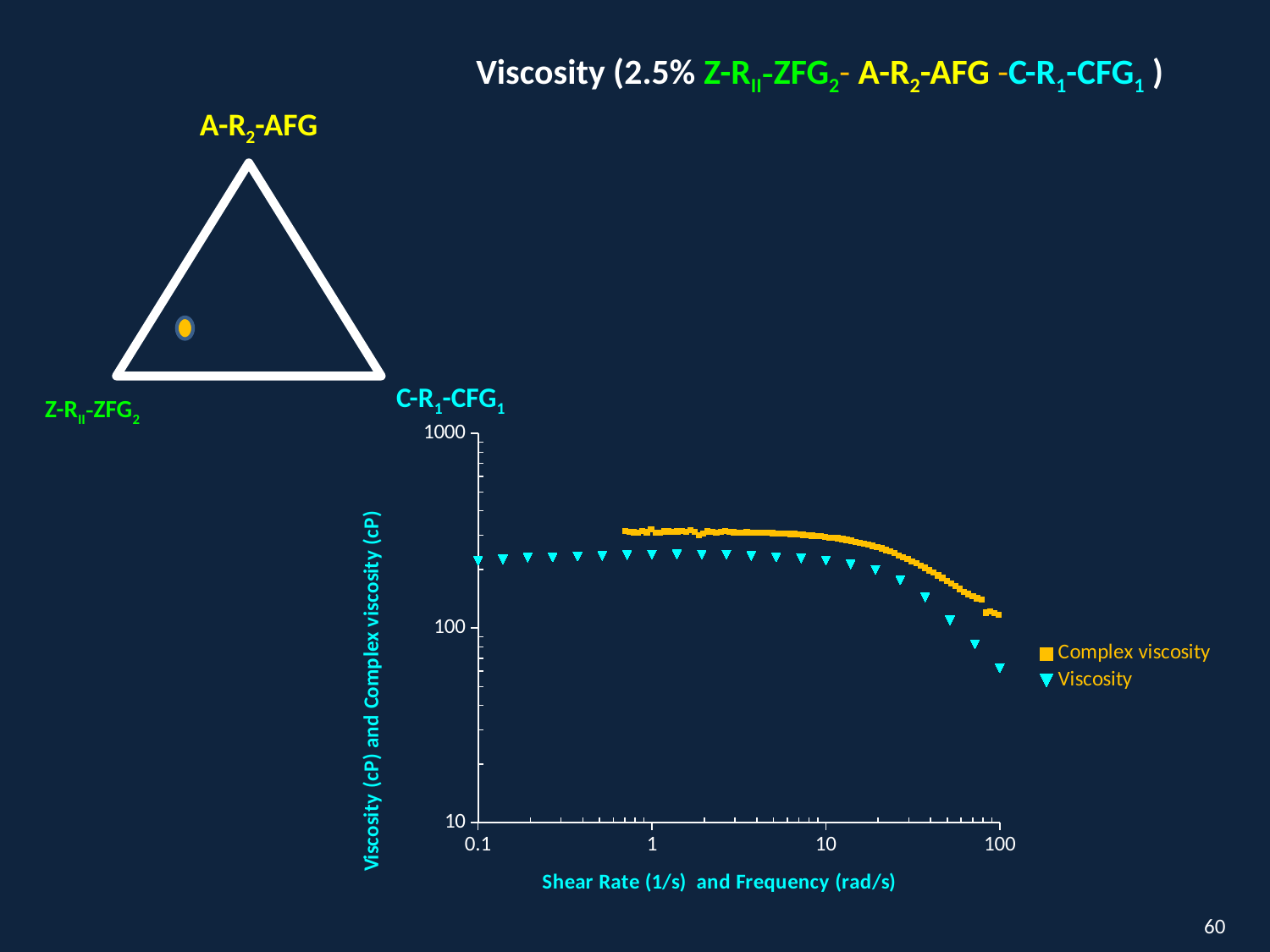
Is the Complex viscosity value at a frequency of 1 greater or less than 100? greater Is the Viscosity value at a shear rate of 100 greater or less than 100? less Is the Complex viscosity value at a frequency of 100 greater or less than 1000? less Does the Viscosity series rise or fall as the shear rate increases from 10 to 100? Fall How many series does the chart legend list? 2 Does the Complex viscosity series rise or fall as the frequency increases from 10 to 100? Fall At an x-axis value of 100, which series has the larger value, Complex viscosity or Viscosity? Complex viscosity What kind of chart is shown on the slide? Scatter chart Which series is plotted with cyan triangle markers? Viscosity What is the lowest value shown on the y axis of the chart? 10 What is the title of the x axis of the chart? Shear Rate (1/s) and Frequency (rad/s)